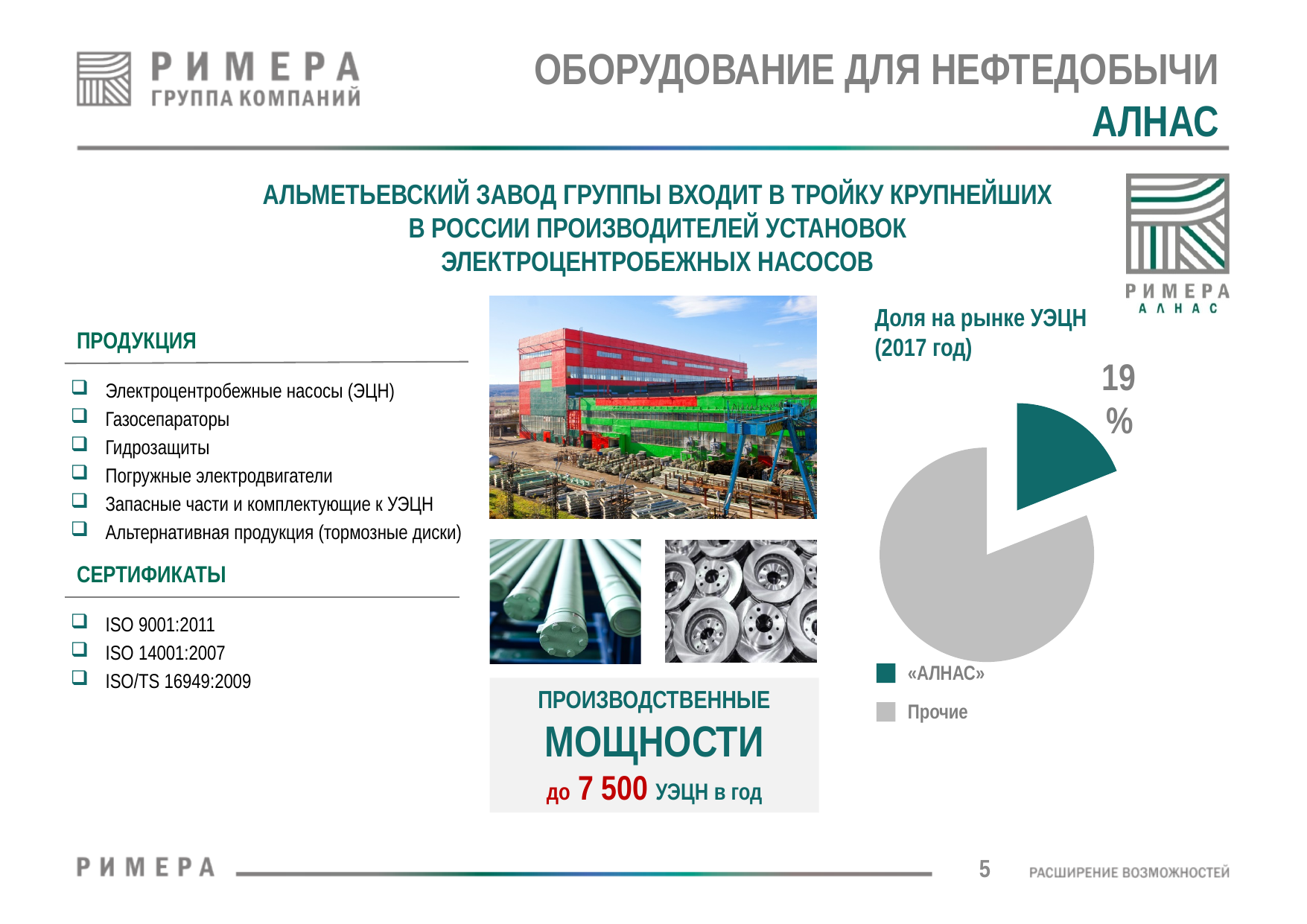
Which slice of the pie chart is the largest? Прочие Which is larger in the pie chart, the «АЛНАС» slice or the Прочие slice? Прочие What colour is the «АЛНАС» slice in the pie chart? teal green Which slice of the pie chart is the smallest? «АЛНАС» How many slices does the pie chart have? 2 What kind of chart is shown under "Доля на рынке УЭЦН (2017 год)"? pie chart What is the market share of «АЛНАС» shown in the pie chart? 19% How many entries does the legend of the pie chart list? 2 What is the title of the pie chart? Доля на рынке УЭЦН (2017 год)